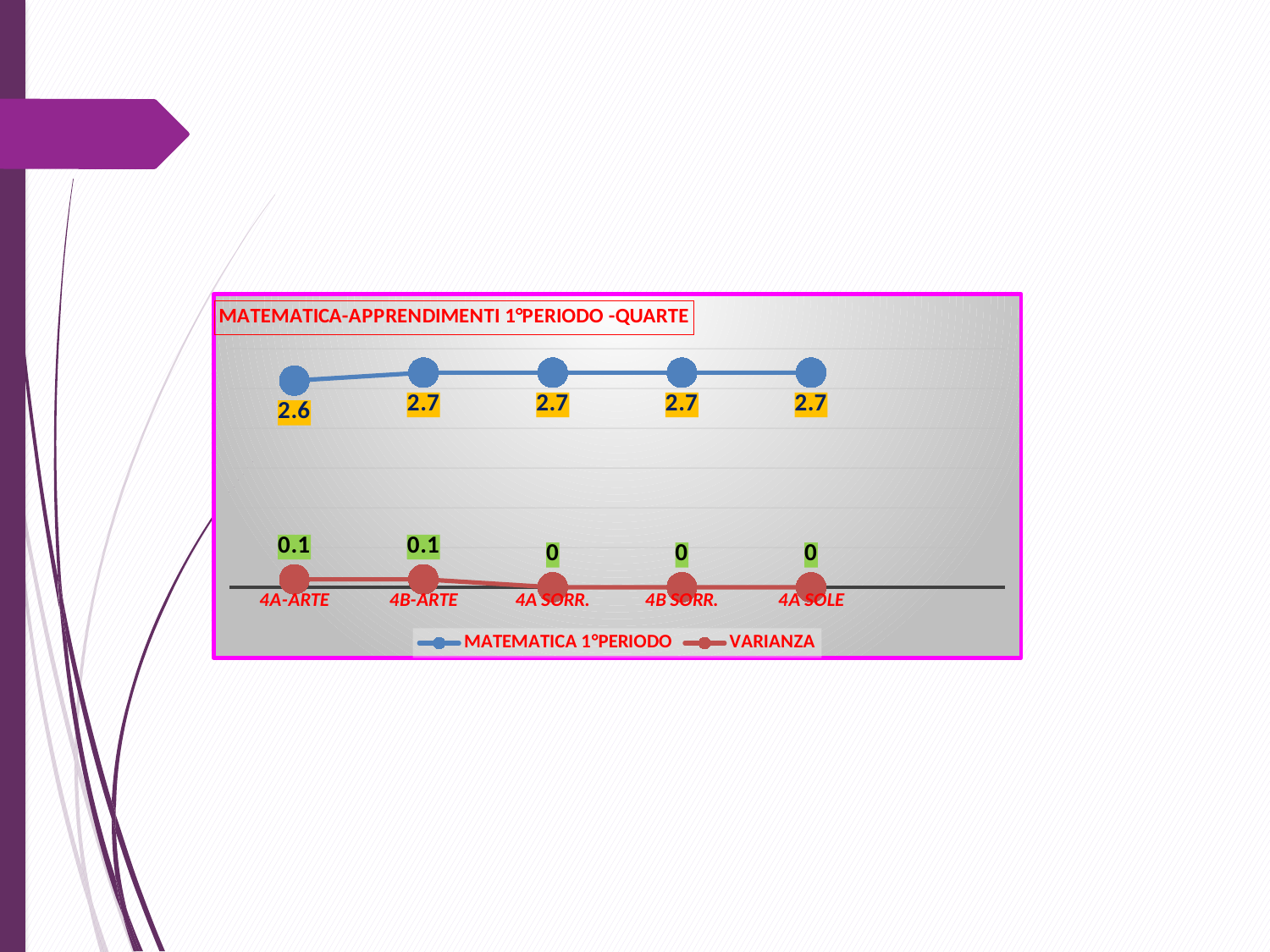
Which is larger, the VARIANZA value for 4A-ARTE or for 4A SORR.? 4A-ARTE What is the MATEMATICA 1°PERIODO value for 4A SOLE? 2.7 What is the MATEMATICA 1°PERIODO value for 4A-ARTE? 2.6 How many series does the legend list? 2 What is the VARIANZA value for 4B SORR.? 0 Does the VARIANZA series rise or fall from 4B-ARTE to 4A SORR.? Fall How many categories are shown on the x axis? 5 What kind of chart is shown on the slide? Line chart What is the title of the chart? MATEMATICA-APPRENDIMENTI 1°PERIODO -QUARTE What is the VARIANZA value for 4B-ARTE? 0.1 What is the difference between the MATEMATICA 1°PERIODO values for 4B-ARTE and 4A-ARTE? 0.1 Which category has the lowest MATEMATICA 1°PERIODO value? 4A-ARTE